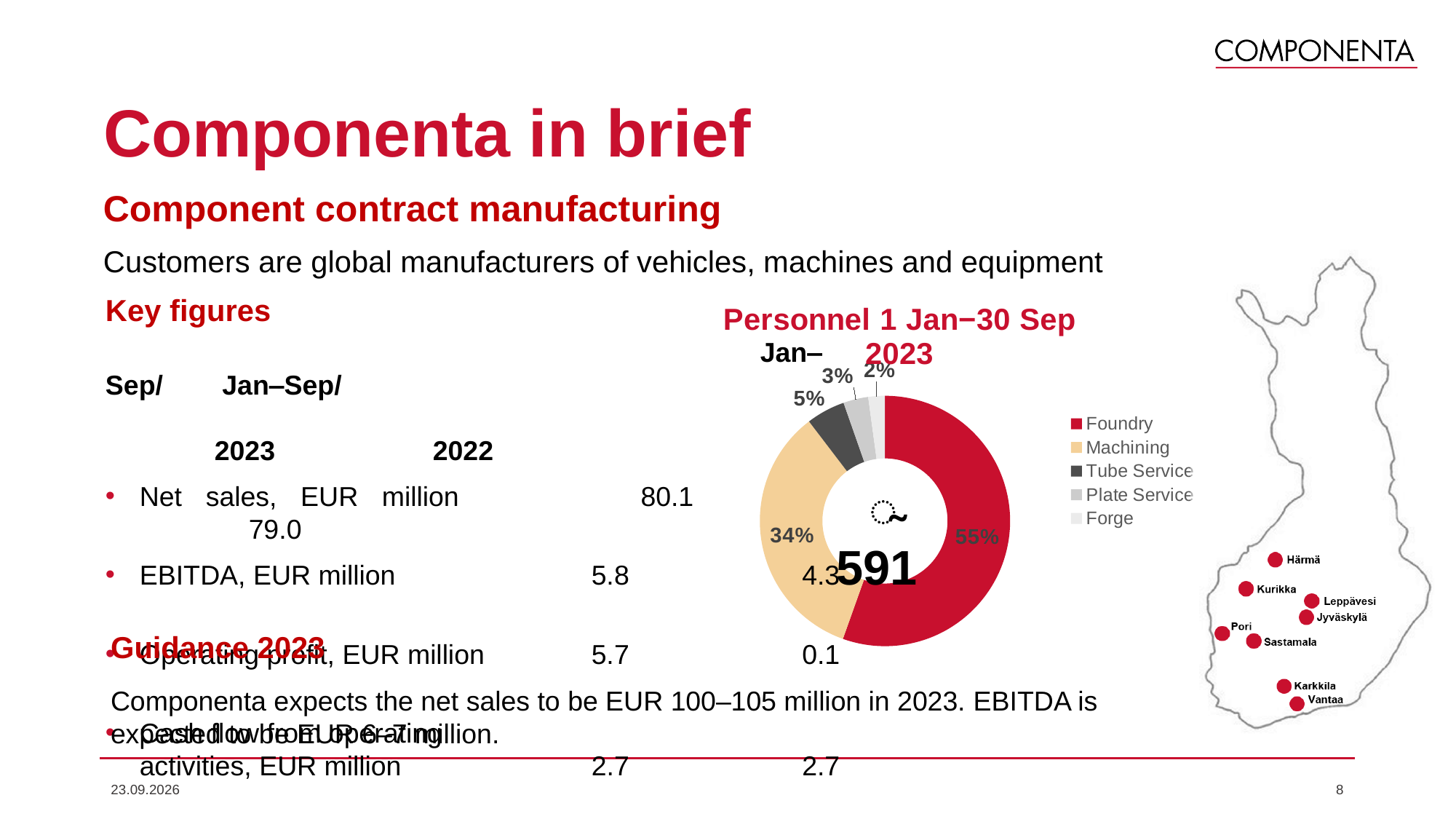
What share of personnel does Forge account for? 2% What share of personnel does Machining account for? 34% Which category has the smallest share of personnel? Forge What is the title of the chart? Personnel 1 Jan−30 Sep 2023 What is the difference in percentage points between the Foundry and Machining shares? 21 percentage points How many categories does the chart's legend list? 5 What kind of chart is shown on the slide? Donut (pie) chart What total number is shown in the centre of the donut chart? 591 What share of personnel does Tube Service account for? 5% Which category has the largest share of personnel? Foundry What share of personnel does Foundry account for? 55% What share of personnel does Plate Service account for? 3%